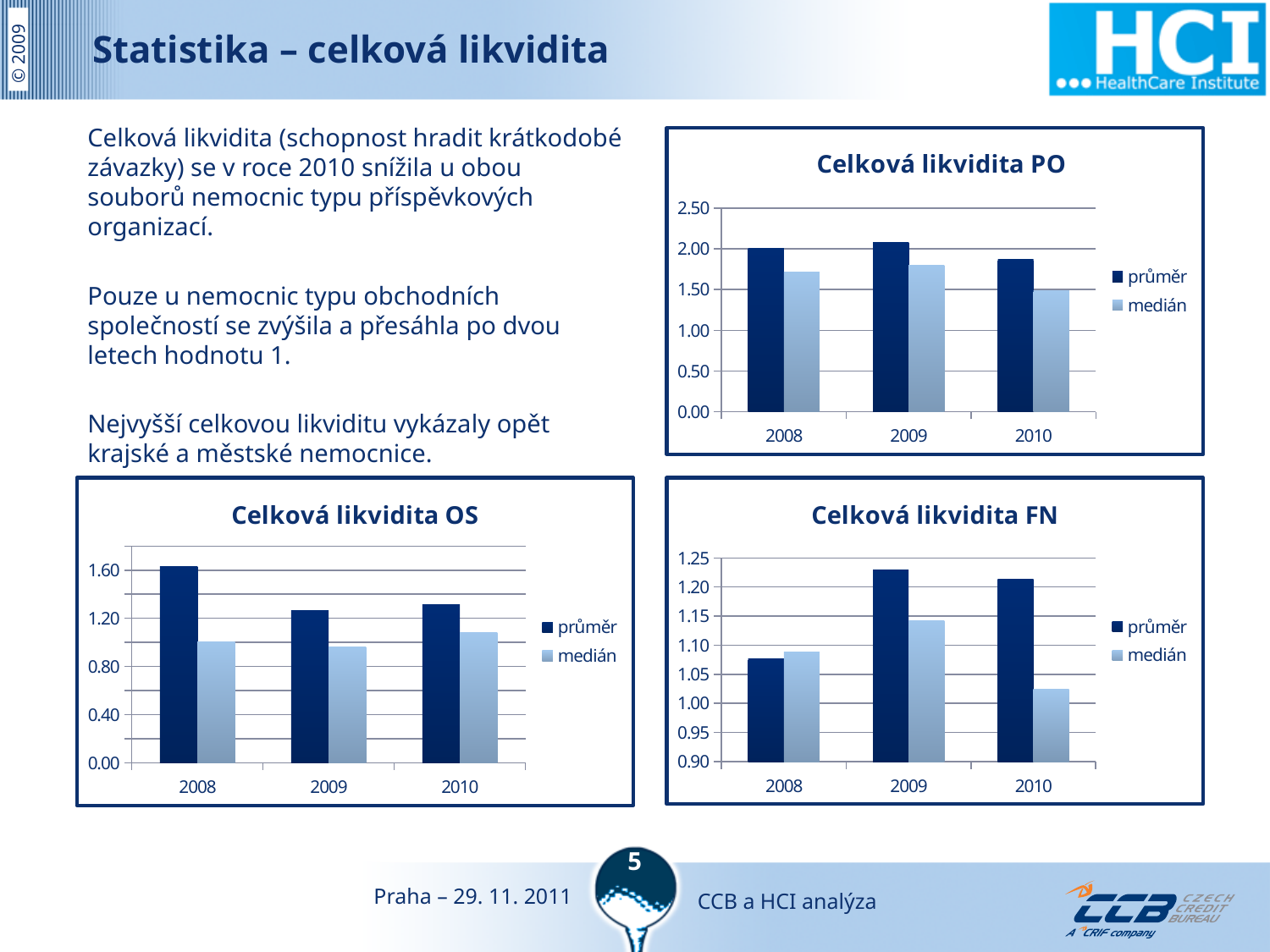
In "Celková likvidita PO", which year has the lowest medián value? 2010 In "Celková likvidita FN", which year has the lowest průměr value? 2008 What are the two legend entries in "Celková likvidita PO"? průměr and medián In "Celková likvidita OS", is the průměr value for 2008 greater or less than 1.20? greater What kind of chart is "Celková likvidita PO"? bar chart In "Celková likvidita PO", does the medián value rise or fall from 2009 to 2010? fall In "Celková likvidita FN", is the medián value for 2009 greater or less than 1.10? greater In "Celková likvidita FN", which is larger in 2010, průměr or medián? průměr How many years are shown on the x axis of "Celková likvidita FN"? 3 How many series does the legend of "Celková likvidita OS" list? 2 In "Celková likvidita PO", which year has the highest průměr value? 2009 In "Celková likvidita OS", which year has the highest průměr value? 2008